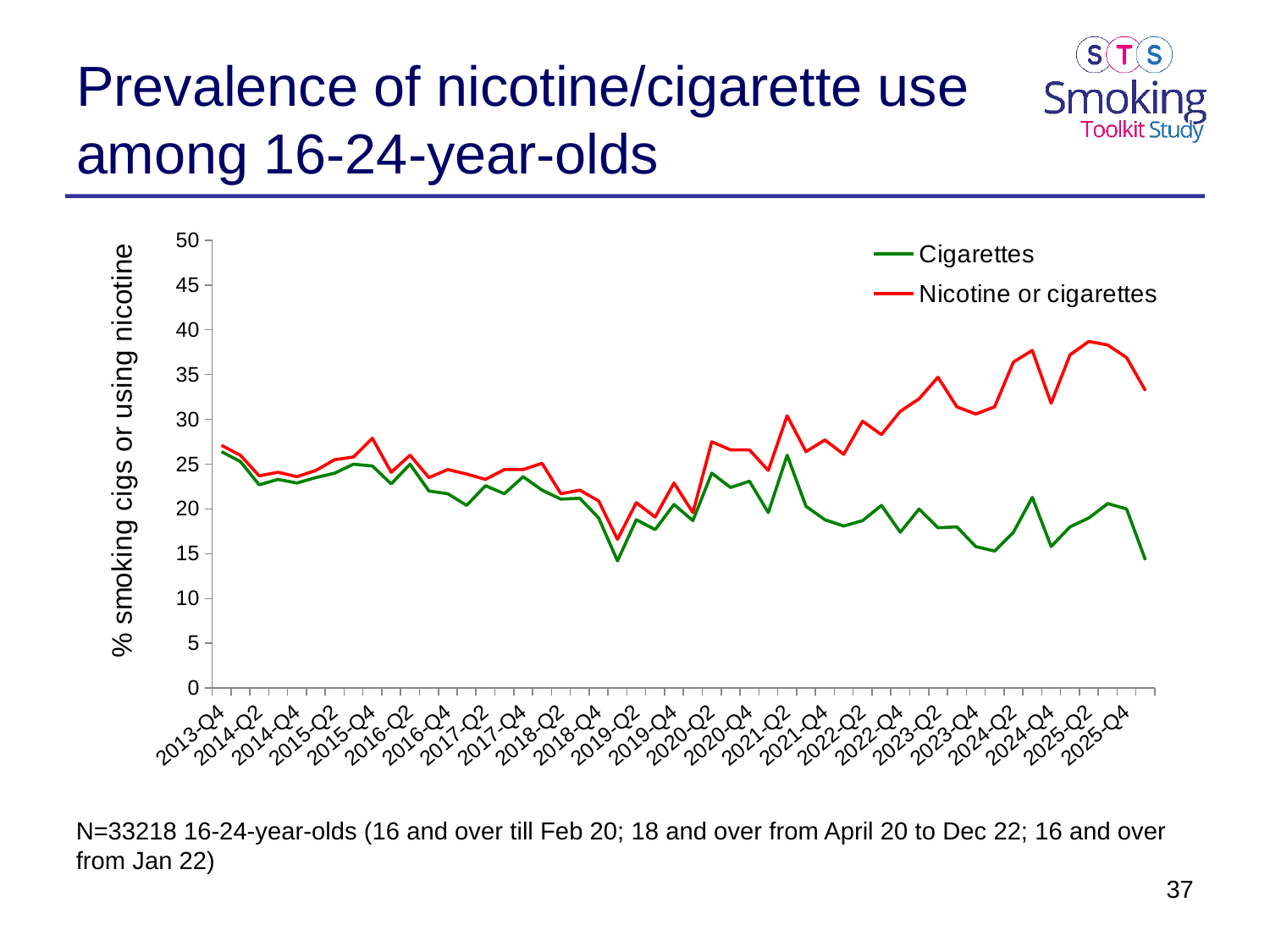
What colour is the line for the Cigarettes series? Green Is the value for Nicotine or cigarettes at 2025-Q4 greater or less than 30? greater Is the value for Cigarettes at 2013-Q4 greater or less than 25? greater How many series does the legend list? 2 Does the Cigarettes line overall rise or fall between 2013-Q4 and 2025-Q4? Fall What is the label on the y axis of the chart? % smoking cigs or using nicotine At 2025-Q2, which series has the higher value, Cigarettes or Nicotine or cigarettes? Nicotine or cigarettes Is the value for Nicotine or cigarettes at 2025-Q2 greater or less than 35? greater What kind of chart is shown on the slide? Line chart Does the Nicotine or cigarettes line overall rise or fall between 2021-Q2 and 2025-Q2? Rise